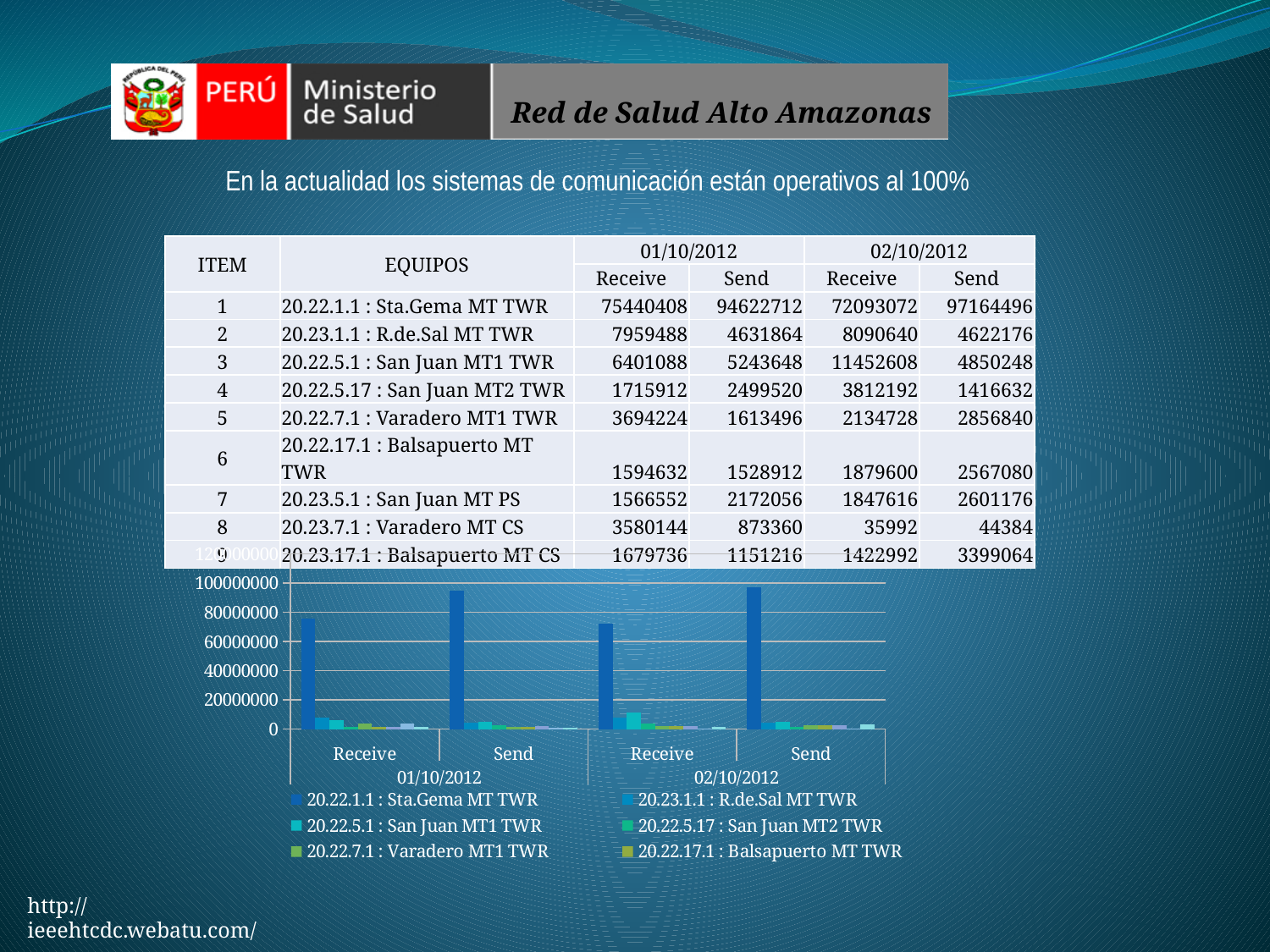
How many series does the chart's legend list? 6 What kind of chart is shown on the slide? bar chart Which series has the tallest bars in every group of the chart? 20.22.1.1 : Sta.Gema MT TWR Is the Send value for 20.22.1.1 : Sta.Gema MT TWR on 01/10/2012 greater or less than 80000000? greater How many category groups are shown along the x axis of the chart? 4 Which two dates are shown on the x axis of the chart? 01/10/2012 and 02/10/2012 Is the Receive value for 20.22.1.1 : Sta.Gema MT TWR on 01/10/2012 greater or less than 60000000? greater For 20.22.1.1 : Sta.Gema MT TWR on 01/10/2012, which is larger, the Receive bar or the Send bar? Send According to the table above the chart, what is the Send value for 20.22.1.1 : Sta.Gema MT TWR on 02/10/2012? 97164496 According to the table above the chart, what is the Receive value for 20.23.1.1 : R.de.Sal MT TWR on 01/10/2012? 7959488 Is the Receive value for 20.22.1.1 : Sta.Gema MT TWR on 02/10/2012 greater or less than 80000000? less Which x-axis group contains the tallest bar in the chart? Send, 02/10/2012